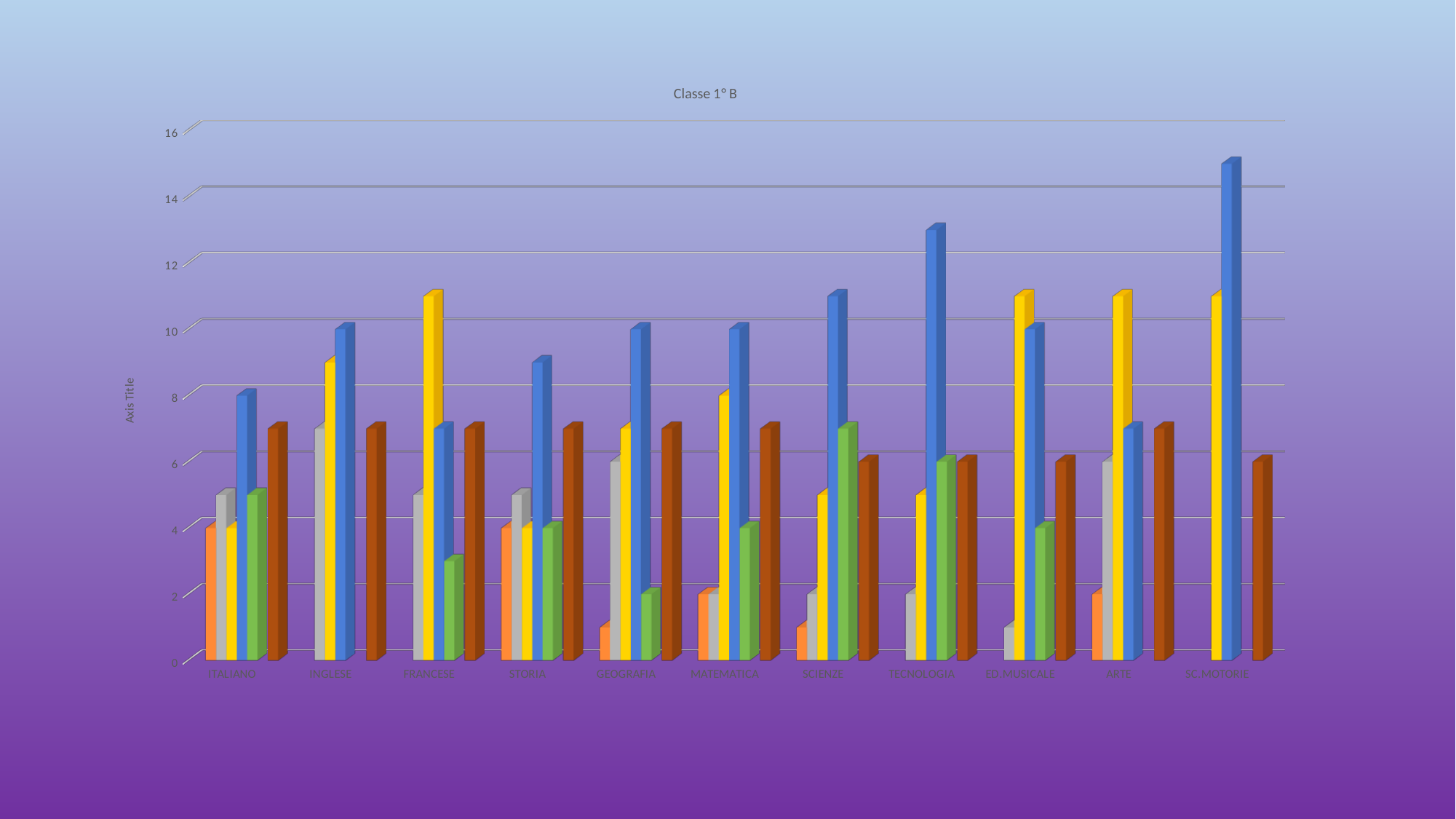
Which is larger for ARTE, the yellow bar or the blue bar? the yellow bar What is the highest value shown on the vertical axis of the chart? 16 Which is larger for TECNOLOGIA, the blue bar or the yellow bar? the blue bar What is the title of the chart? Classe 1° B Is the value of the blue bar for TECNOLOGIA greater or less than 12? greater Is the value of the blue bar for SC.MOTORIE greater or less than 14? greater Is the value of the orange bar for GEOGRAFIA greater or less than 2? less Which category has the tallest blue bar? SC.MOTORIE What kind of chart is shown on the slide? bar chart How many categories are shown along the x axis of the chart? 11